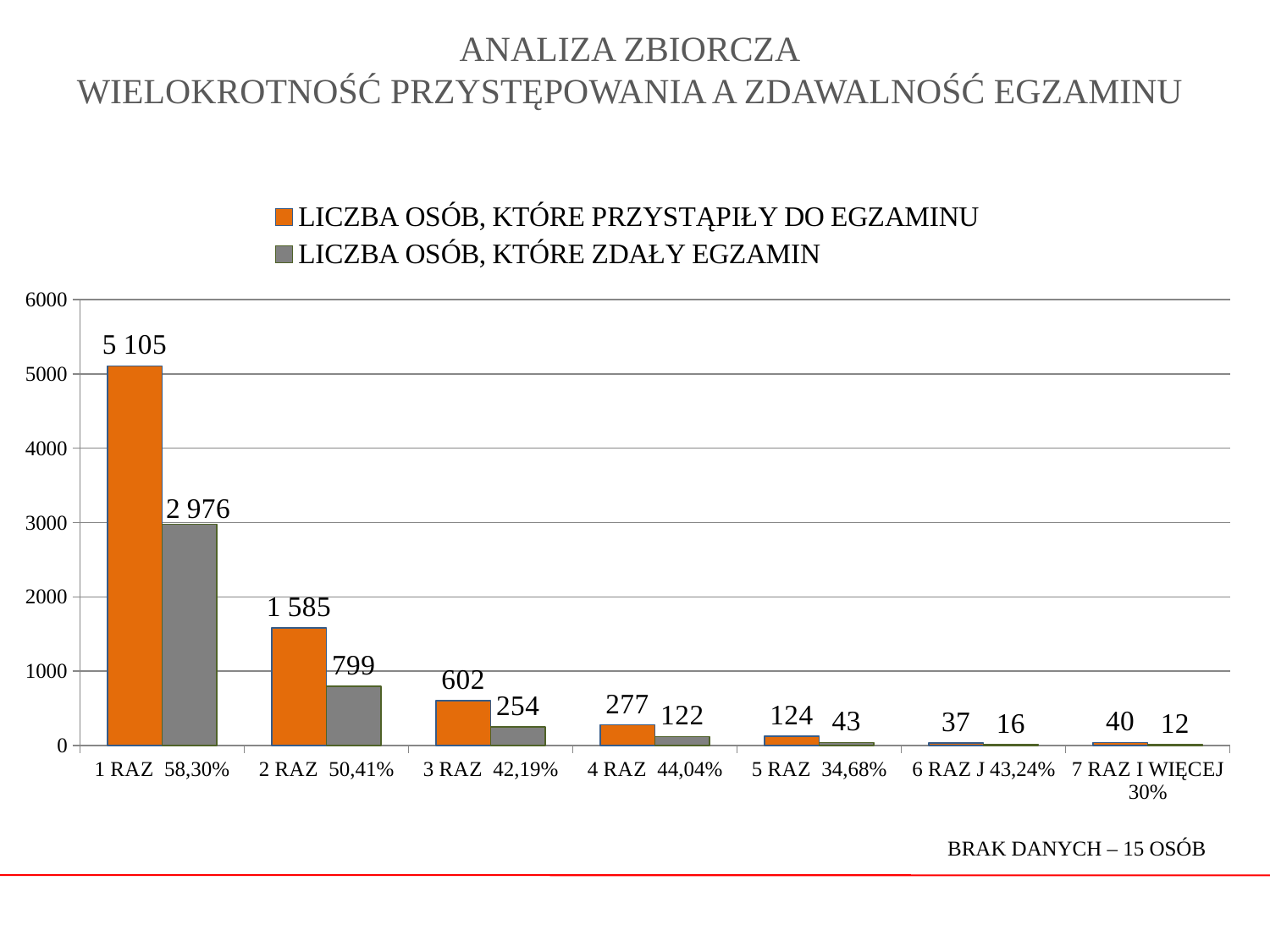
What type of chart is shown on the slide? Bar chart How many people took the exam for the first time (1 RAZ) according to the chart? 5 105 How many people passed the exam in the 2 RAZ category? 799 Which colour represents the series 'LICZBA OSÓB, KTÓRE ZDAŁY EGZAMIN' in the legend? Grey Which category has the lowest number of people who passed the exam? 7 RAZ I WIĘCEJ Which is larger: the number of people who passed in the 4 RAZ category or the number who took the exam in the 5 RAZ category? 5 RAZ took the exam (124) How many categories are shown on the x axis of the chart? 7 What is the difference between the number of people who took the exam and the number who passed it in the 3 RAZ category? 348 What is the number of people who took the exam in the 5 RAZ category? 124 How many series does the legend list? 2 Which category has the highest number of people who took the exam? 1 RAZ Do the values for the number of people who took the exam rise or fall from 1 RAZ to 5 RAZ? Fall